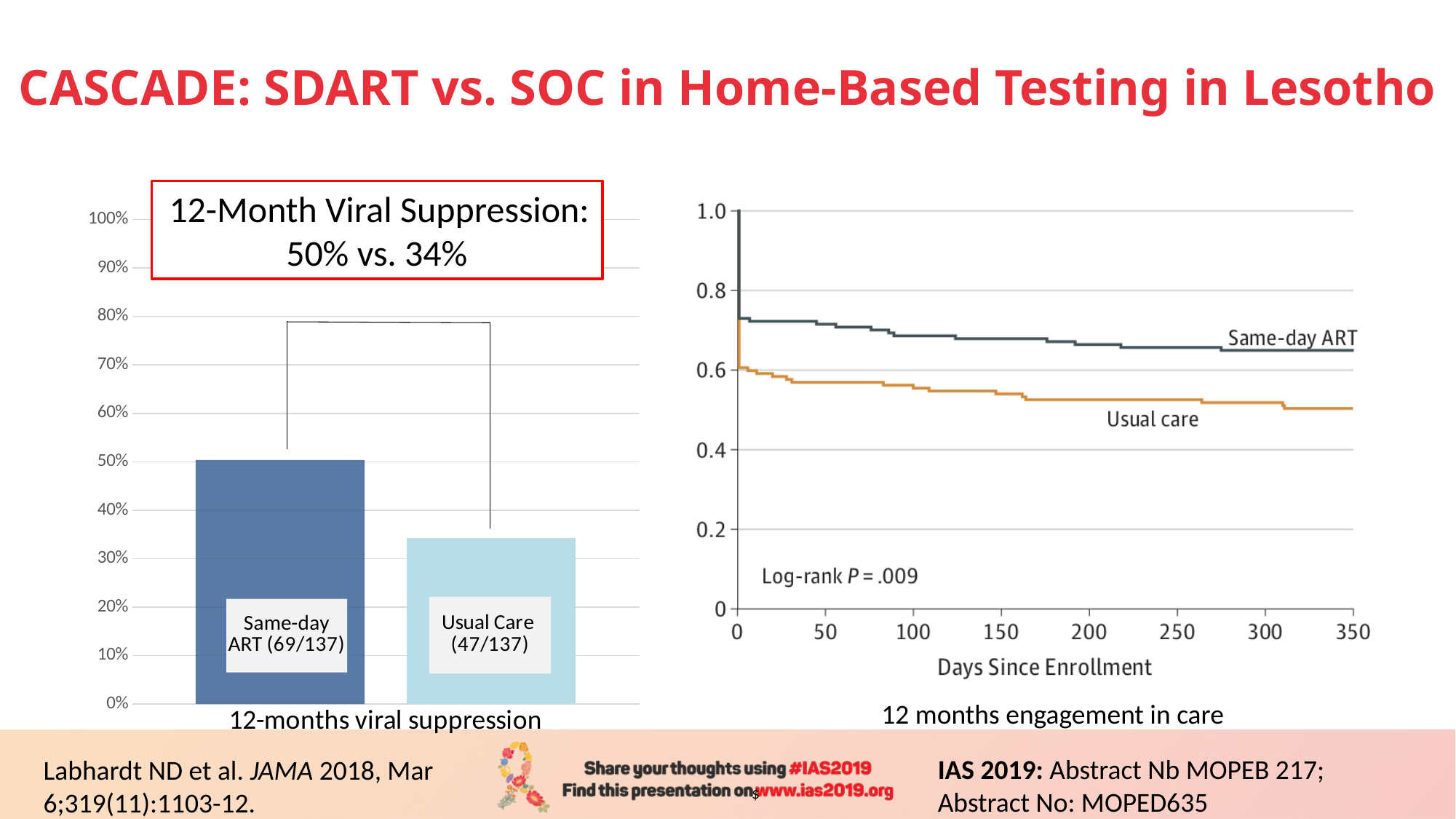
What kind of chart is the 12-months viral suppression chart on the left? Bar chart On the 12 months engagement in care chart, is the Usual care curve at 350 days greater or less than 0.6? less On the 12-months viral suppression bar chart, which group has the higher viral suppression? Same-day ART On the 12-months viral suppression bar chart, what is the difference in viral suppression between Same-day ART and Usual Care? 16% On the 12 months engagement in care chart, do the curves rise or fall as days since enrollment increase? Fall On the 12-months viral suppression bar chart, what is the 12-month viral suppression value for Same-day ART? 50% On the 12-months viral suppression bar chart, how many participants in the Usual Care group were virally suppressed? 47 On the 12 months engagement in care chart, is the Same-day ART curve at 350 days greater or less than 0.6? greater On the 12 months engagement in care chart, what is the log-rank P value shown? P = .009 On the 12-months viral suppression bar chart, how many bars are shown? 2 On the 12-months viral suppression bar chart, how many participants were in the Same-day ART group? 137 On the 12-months viral suppression bar chart, what is the 12-month viral suppression value for Usual Care? 34%